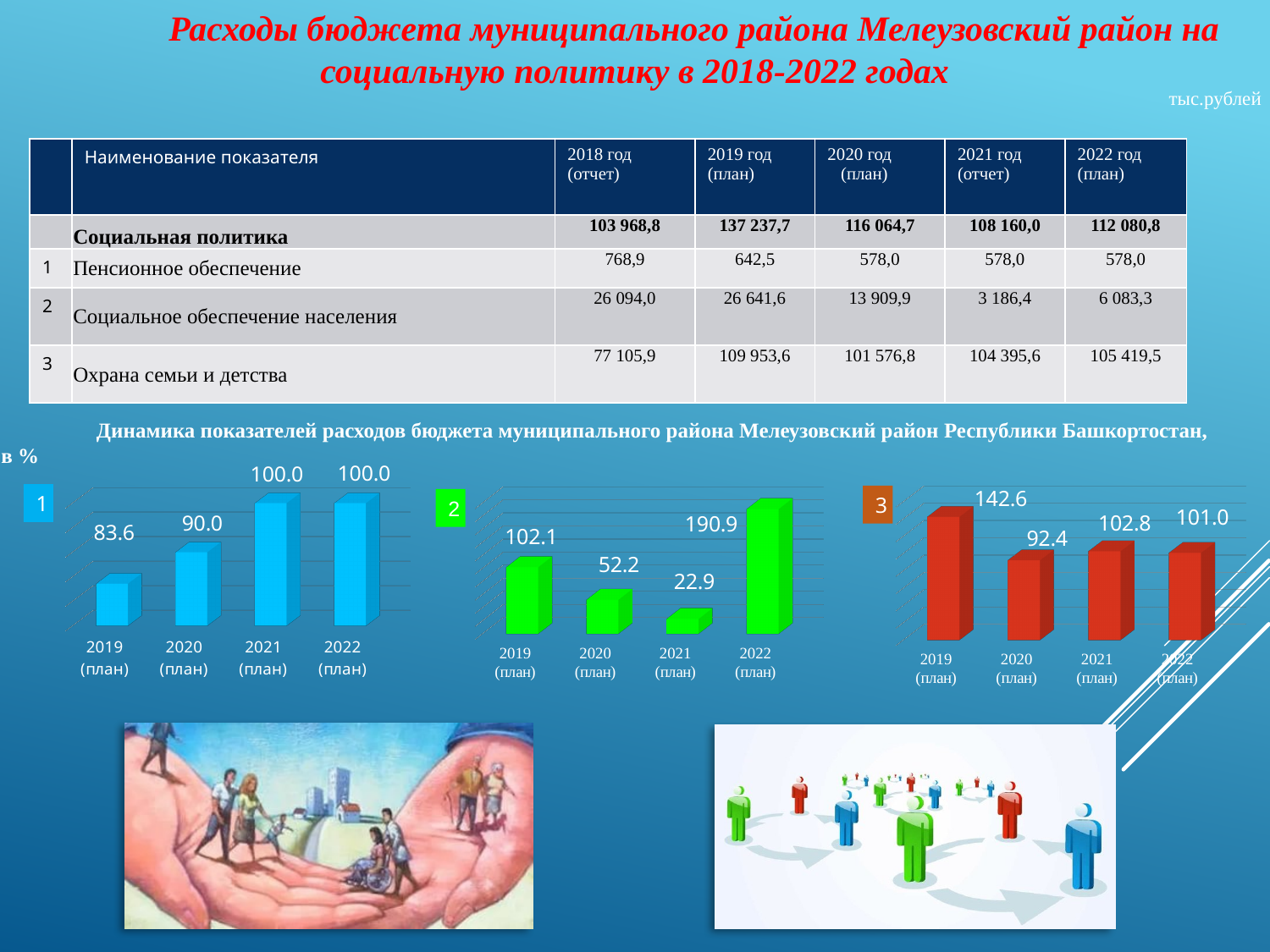
How many bars are in the blue bar chart labelled 1 (left)? 4 In the green bar chart labelled 2 (middle), which year has the highest value? 2022 (план) In the red bar chart labelled 3 (right), what is the value for 2019 (план)? 142.6 What type of chart is the red chart labelled 3 (right)? Bar chart In the blue bar chart labelled 1 (left), what is the value for 2020 (план)? 90.0 In the red bar chart labelled 3 (right), which year has the highest value? 2019 (план) In the green bar chart labelled 2 (middle), which year has the lowest value? 2021 (план) In the green bar chart labelled 2 (middle), which is larger: the value for 2019 (план) or 2022 (план)? 2022 (план) In the red bar chart labelled 3 (right), what is the difference between the values for 2019 (план) and 2020 (план)? 50.2 In the blue bar chart labelled 1 (left), what is the value for 2019 (план)? 83.6 In the green bar chart labelled 2 (middle), what is the value for 2020 (план)? 52.2 In the blue bar chart labelled 1 (left), do the values rise or fall from 2019 to 2021? Rise